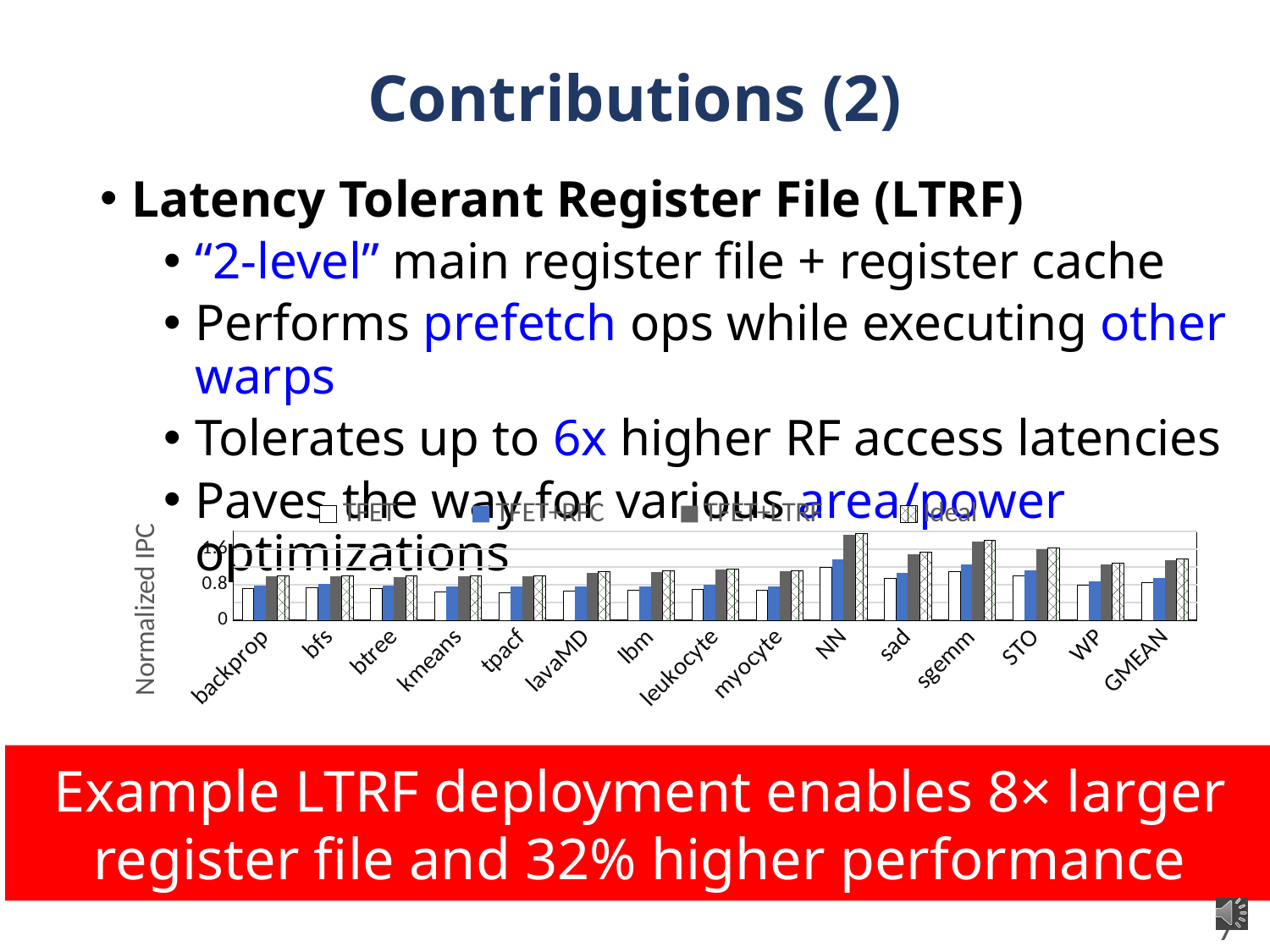
What is the label of the chart's y axis? Normalized IPC Is the TFET+LTRF value for NN greater or less than 0.8? greater How many series does the chart's legend list? 4 Which category has the highest Ideal bar? NN Which is larger, the Ideal value for sgemm or the Ideal value for bfs? sgemm Which category is the last one on the x axis of the chart? GMEAN Is the TFET+LTRF value for sgemm greater or less than 0.8? greater Is the TFET+LTRF value for GMEAN greater or less than 0.8? greater How many categories are shown along the x axis of the chart? 15 Which is larger, the TFET+LTRF value for NN or the TFET+LTRF value for backprop? NN What kind of chart is shown on the slide? bar chart